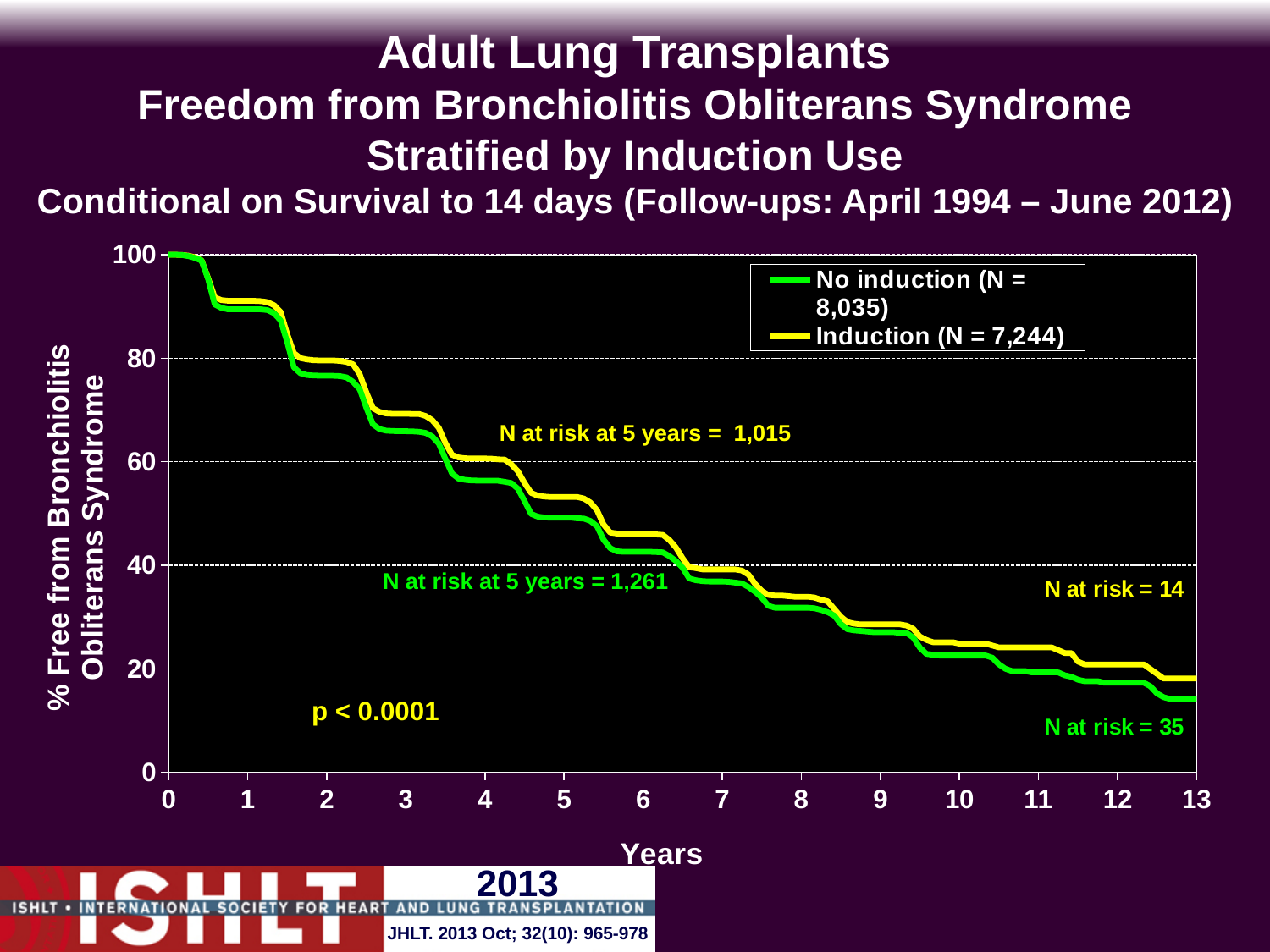
Is the value for the No induction series at 1 year greater or less than 80? greater What is the N for the No induction group shown in the legend? 8,035 What is the N at risk at 5 years for the No induction group? 1,261 What kind of chart is shown on the slide? line chart What is the N at risk at 5 years for the Induction group? 1,015 Is the value for the Induction series at 5 years greater or less than 40? greater What p-value is printed on the chart? p < 0.0001 Is the value for the No induction series at 13 years greater or less than 20? less At 5 years, which series has the higher value, Induction or No induction? Induction How many series does the legend list? 2 Do the values for the Induction series rise or fall as years increase? fall